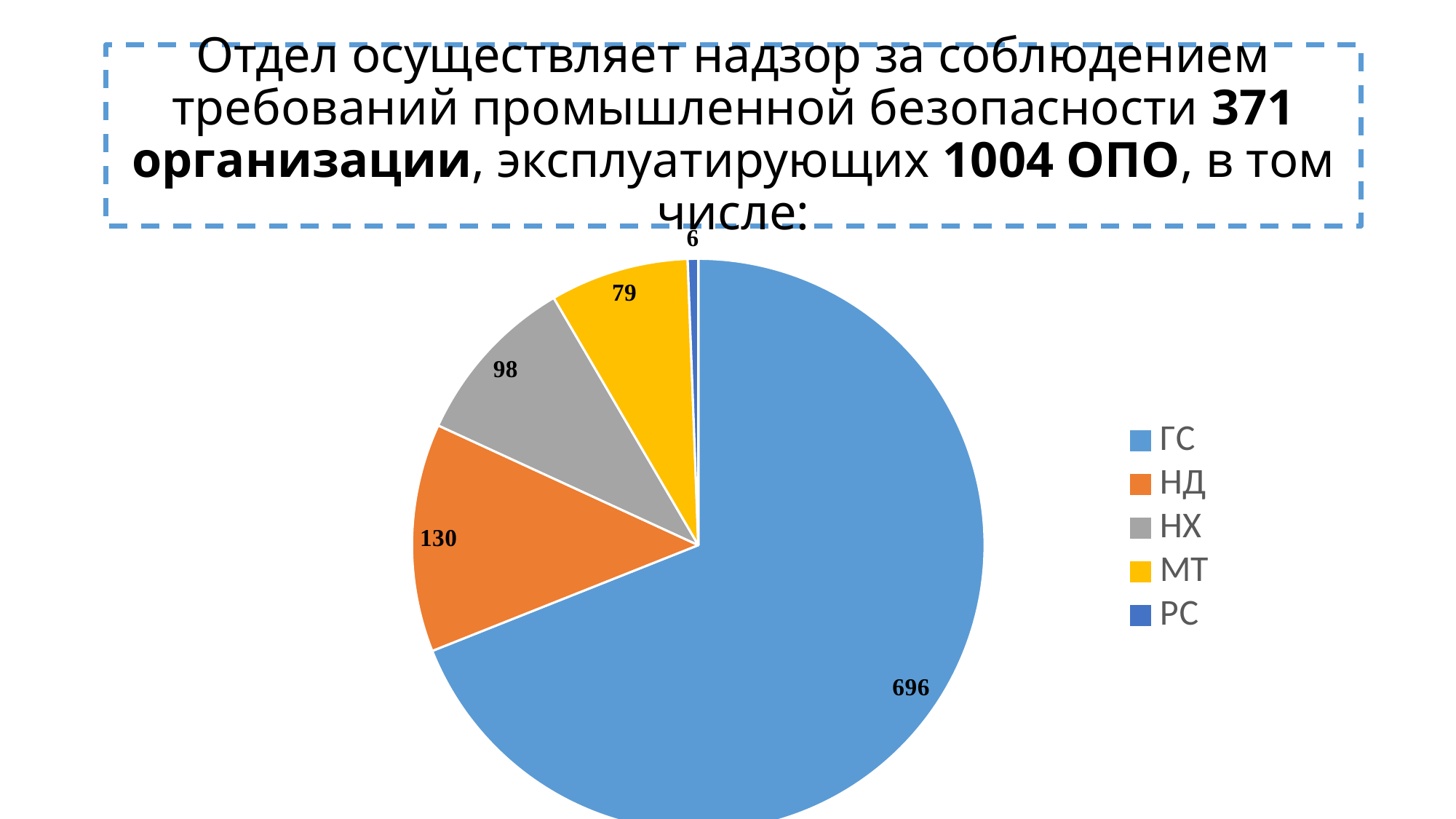
What colour is the slice for МТ in the pie chart? yellow Which is larger, the value for НХ or the value for МТ? НХ What is the difference between the values for ГС and НД? 566 What is the value for ГС in the pie chart? 696 Which category has the smallest slice in the pie chart? РС What is the value for МТ in the pie chart? 79 What is the value for НД in the pie chart? 130 How many categories does the pie chart have? 5 What type of chart is shown on the slide? pie chart What is the value for РС in the pie chart? 6 Which category has the largest slice in the pie chart? ГС What is the value for НХ in the pie chart? 98